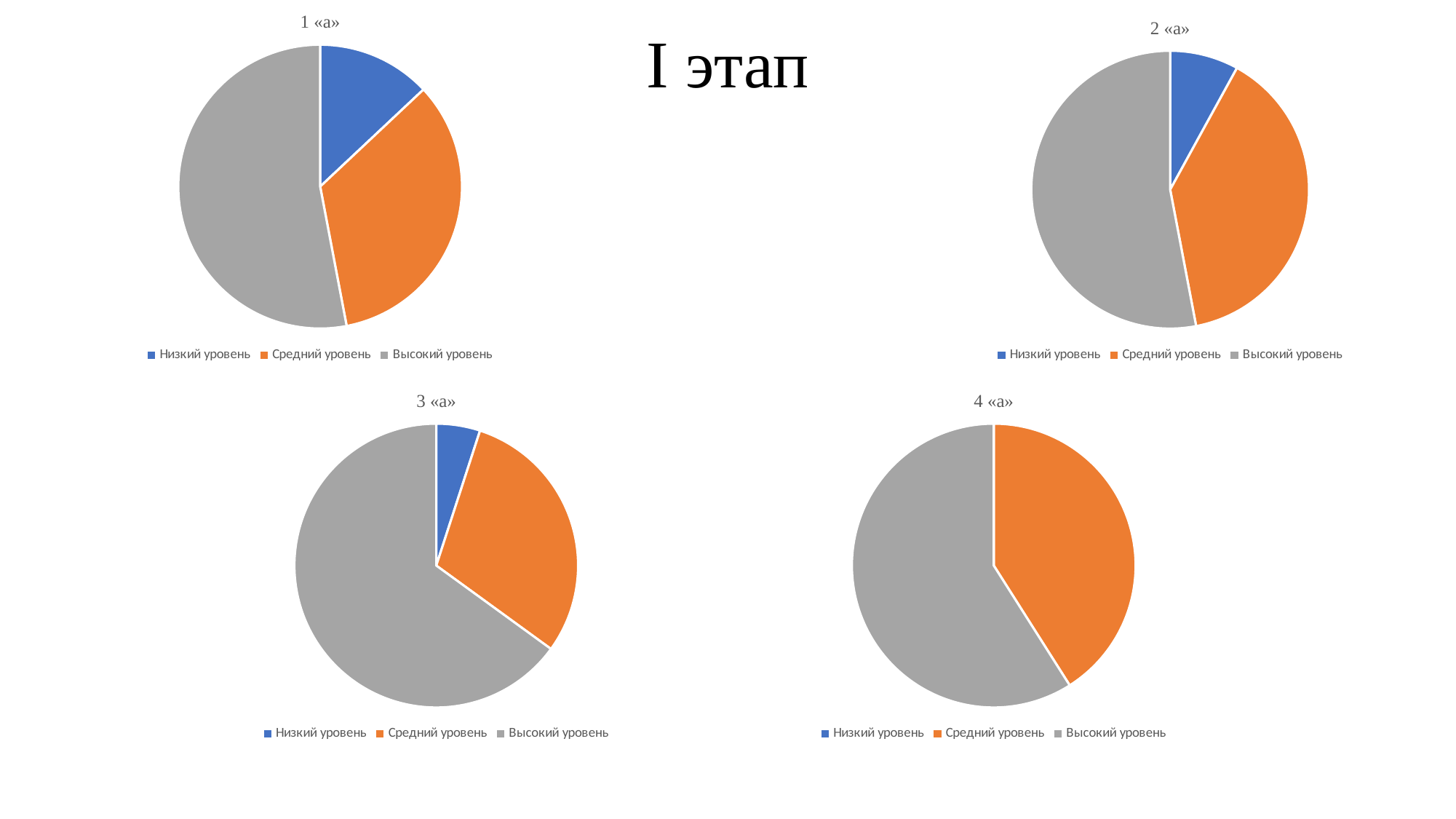
In the chart titled 1 «а», which category has the smallest slice? Низкий уровень How many slices are visible in the chart titled 4 «а»? 2 In the chart titled 3 «а», which category has the largest slice? Высокий уровень In the chart titled 1 «а», which category has the largest slice? Высокий уровень In the chart titled 2 «а», which category has the smallest slice? Низкий уровень What kind of chart is the chart titled 1 «а»? pie chart How many entries does the legend of the chart titled 3 «а» list? 3 In the chart titled 3 «а», which is larger: the slice for Средний уровень or the slice for Высокий уровень? Высокий уровень In the chart titled 2 «а», which category has the largest slice? Высокий уровень How many pie charts are shown on the slide? 4 In the chart titled 2 «а», what colour is the slice for Средний уровень? orange In the chart titled 4 «а», which is larger: the slice for Средний уровень or the slice for Высокий уровень? Высокий уровень